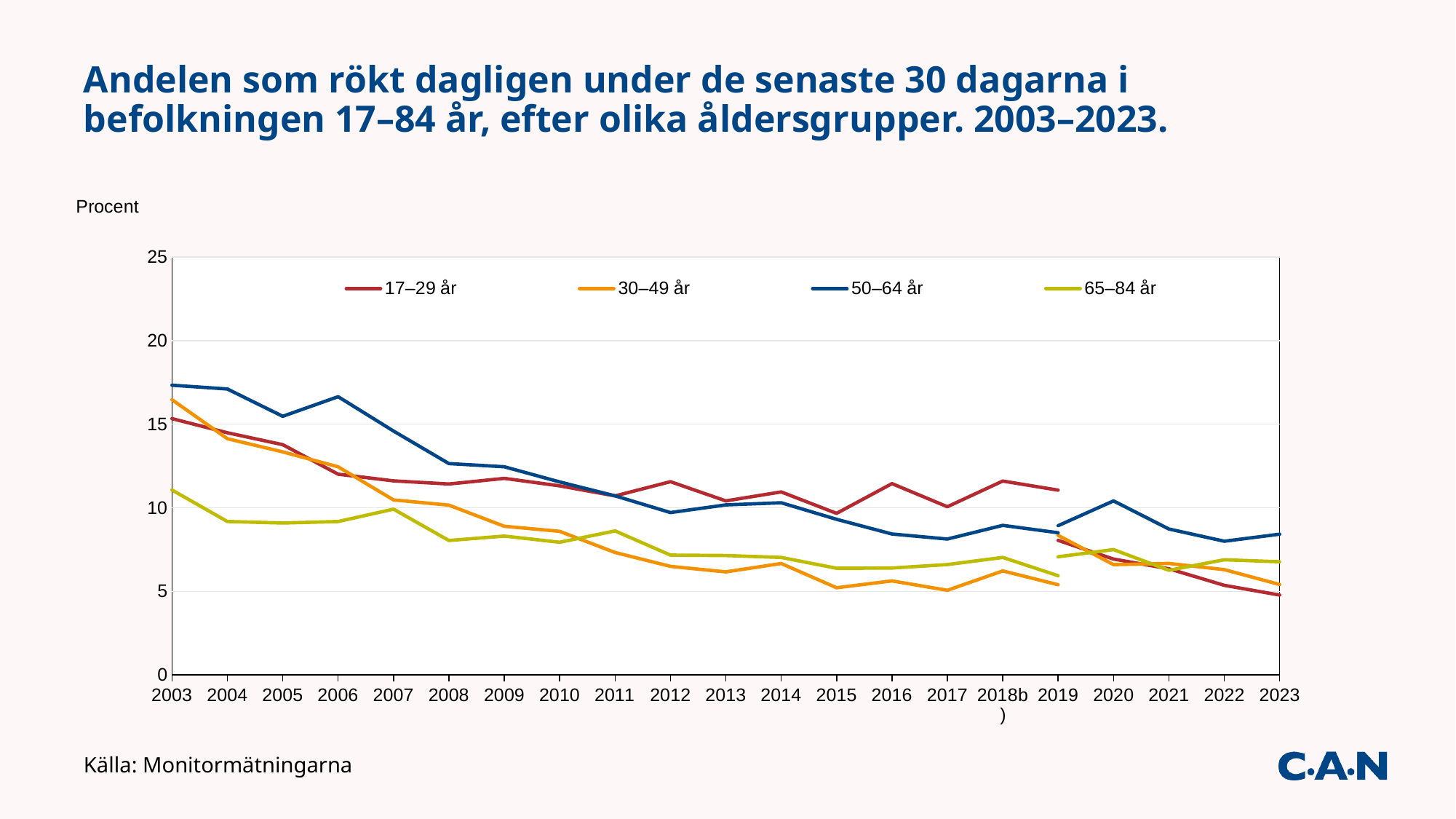
Which age group has the lowest value in 2003? 65–84 år What kind of chart is shown on the slide? Line chart How many points are shown along the x axis? 21 What label is shown on the y axis of the chart? Procent Is the value for 30–49 år in 2013 greater or less than 10? less Is the value for 65–84 år in 2003 greater or less than 10? greater How many series does the legend list? 4 Is the value for 50–64 år in 2003 greater or less than 15? greater Which age group has the highest value in 2003? 50–64 år Does the value for 50–64 år rise or fall overall from 2003 to 2023? Fall In 2023, which is larger: the value for 50–64 år or the value for 17–29 år? 50–64 år